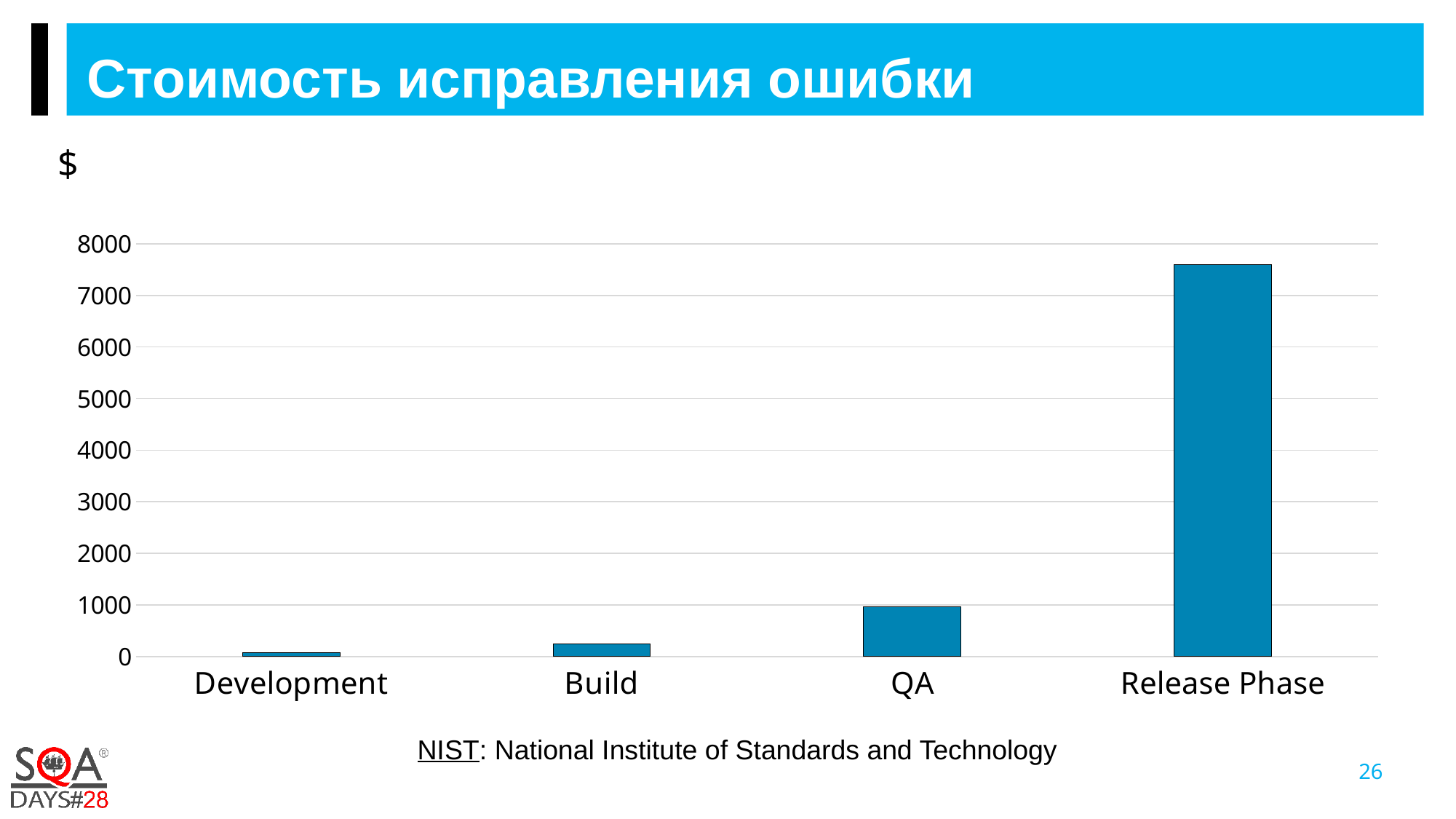
Which category has the highest value in the chart? Release Phase Is the value for Build greater or less than 1000? less Do the values rise or fall from Development to Release Phase along the x axis? rise How many categories are shown on the x axis of the chart? 4 What kind of chart is shown on the slide? bar chart What is the title of the slide containing the chart? Стоимость исправления ошибки Is the value for Release Phase greater or less than 7000? greater Which has a larger value, Release Phase or QA? Release Phase Is the value for QA greater or less than 2000? less Which has a larger value, QA or Build? QA What unit symbol is shown above the vertical axis of the chart? $ Which category has the lowest value in the chart? Development